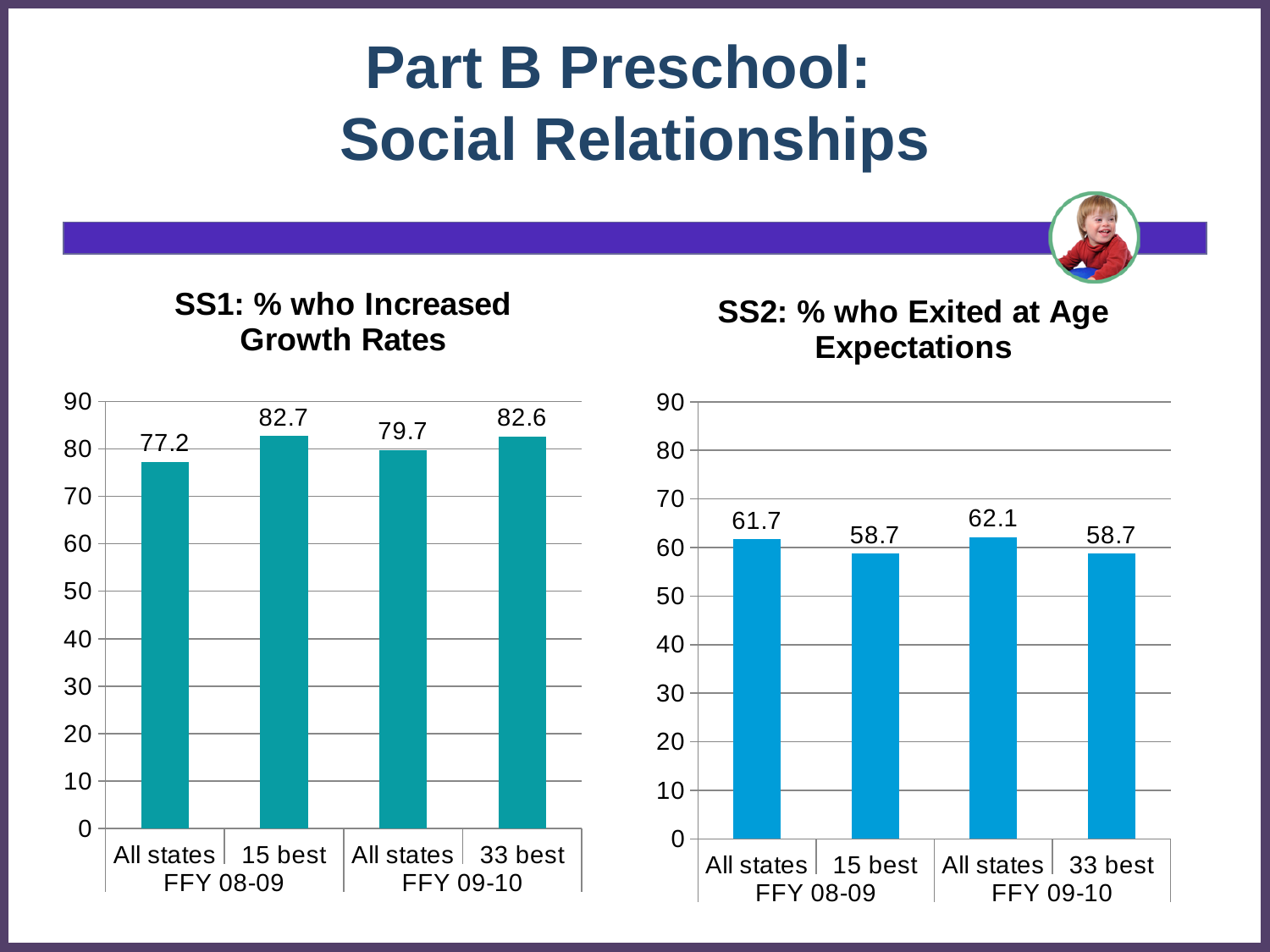
In the SS1: % who Increased Growth Rates chart, what is the value for All states in FFY 08-09? 77.2 In the SS2: % who Exited at Age Expectations chart, which bar has the highest value? All states, FFY 09-10 In the SS2: % who Exited at Age Expectations chart, what is the value for All states in FFY 09-10? 62.1 In the SS1: % who Increased Growth Rates chart, what is the value for 33 best in FFY 09-10? 82.6 In the SS1: % who Increased Growth Rates chart, which bar has the lowest value? All states, FFY 08-09 In the SS2: % who Exited at Age Expectations chart, which is larger: All states in FFY 08-09 or 15 best in FFY 08-09? All states in FFY 08-09 In the SS1: % who Increased Growth Rates chart, what is the difference between the 15 best value and the All states value in FFY 08-09? 5.5 What kind of chart is the SS2: % who Exited at Age Expectations chart? Bar chart In the SS2: % who Exited at Age Expectations chart, what is the value for 15 best in FFY 08-09? 58.7 In the SS1: % who Increased Growth Rates chart, is the value for All states in FFY 09-10 greater or less than 80? less In the SS2: % who Exited at Age Expectations chart, what is the difference between the All states value and the 33 best value in FFY 09-10? 3.4 How many bars are plotted in the SS1: % who Increased Growth Rates chart? 4